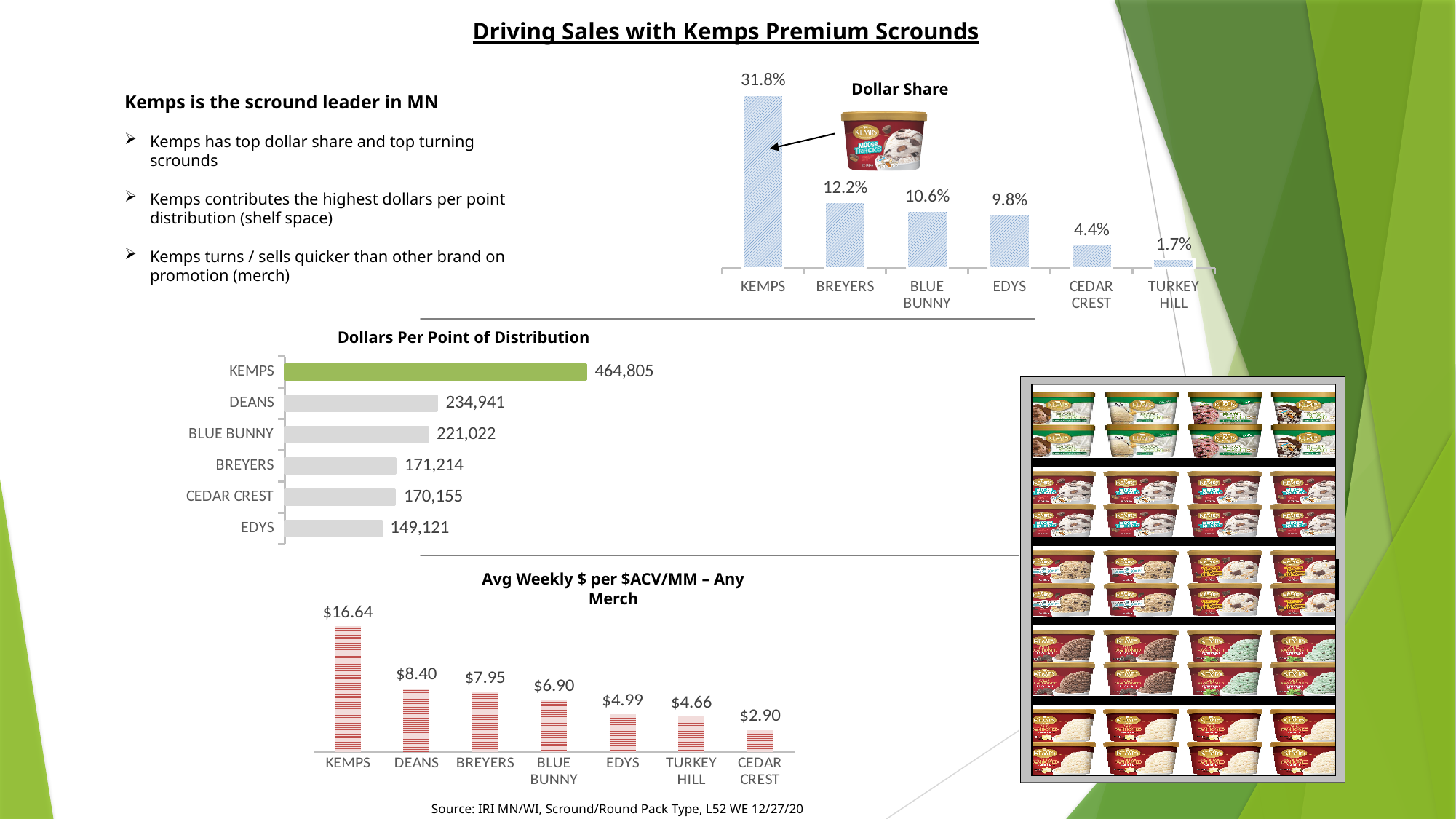
In the Dollar Share chart, how many brands are shown? 6 In the Dollar Share chart, what is the difference between BREYERS and BLUE BUNNY? 1.6% In the Dollars Per Point of Distribution chart, what is the value for BLUE BUNNY? 221,022 In the Dollars Per Point of Distribution chart, what is the difference between KEMPS and DEANS? 229,864 In the Avg Weekly $ per $ACV/MM – Any Merch chart, do the values rise or fall from left to right? Fall In the Dollars Per Point of Distribution chart, which is larger, BREYERS or CEDAR CREST? BREYERS In the Dollars Per Point of Distribution chart, which brand has the highest value? KEMPS In the Dollar Share chart, which brand has the lowest dollar share? TURKEY HILL In the Avg Weekly $ per $ACV/MM – Any Merch chart, which brand has the lowest value? CEDAR CREST What type of chart is the Dollars Per Point of Distribution chart? Bar chart In the Dollar Share chart, what is the value for KEMPS? 31.8% In the Avg Weekly $ per $ACV/MM – Any Merch chart, what is the value for EDYS? $4.99